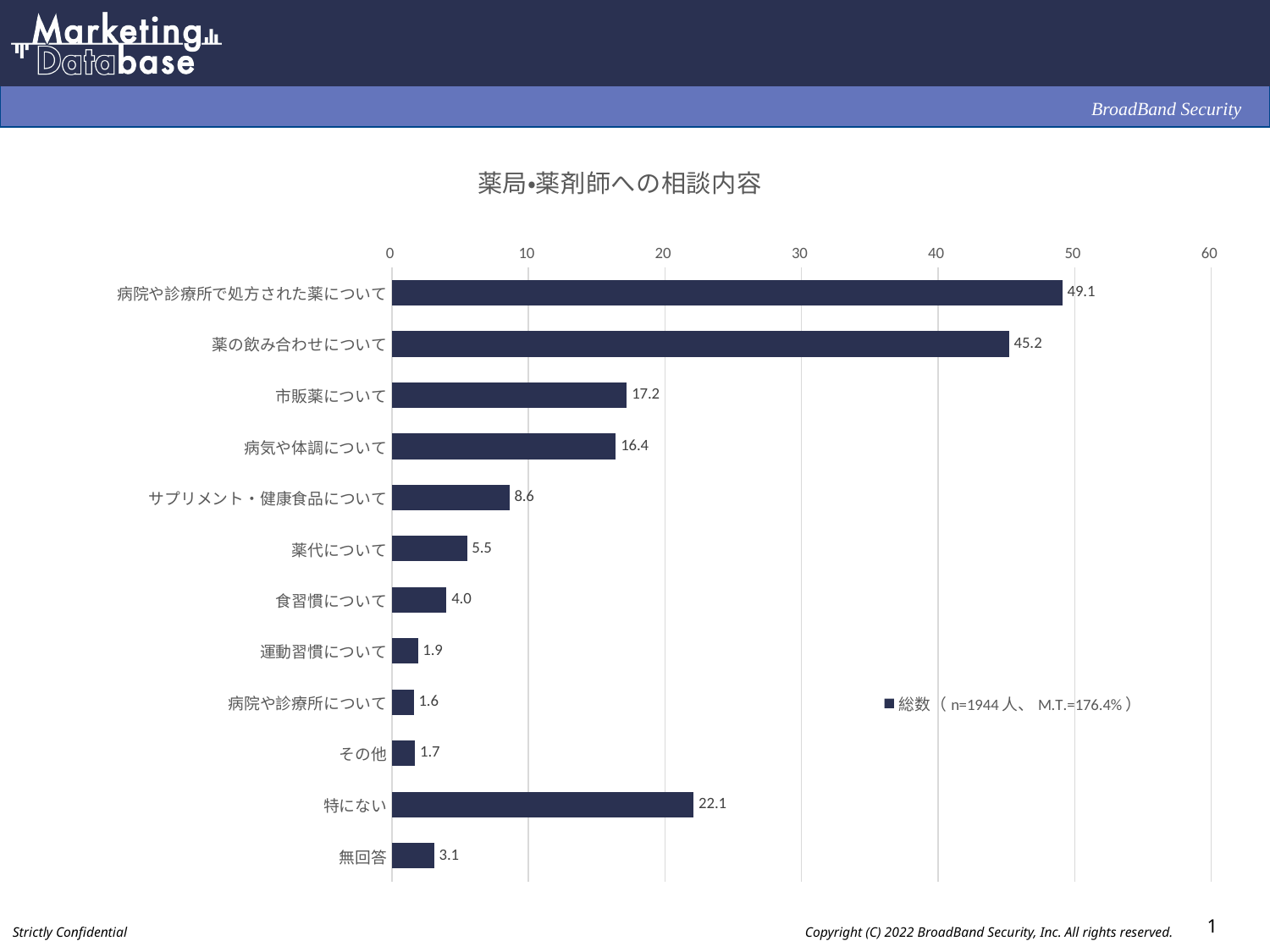
Is the value for 薬の飲み合わせについて greater or less than 40? greater What kind of chart is shown on the slide? bar chart What is the value for サプリメント・健康食品について? 8.6 What is the value for 特にない? 22.1 What is the value for 病院や診療所で処方された薬について? 49.1 Which category has the highest value? 病院や診療所で処方された薬について Which category has the lowest value? 病院や診療所について What is the title of the chart? 薬局•薬剤師への相談内容 How many series does the legend list? 1 What is the difference between the values for 病院や診療所で処方された薬について and 薬の飲み合わせについて? 3.9 Which is larger, the value for 市販薬について or the value for 病気や体調について? 市販薬について How many categories are shown in the chart? 12